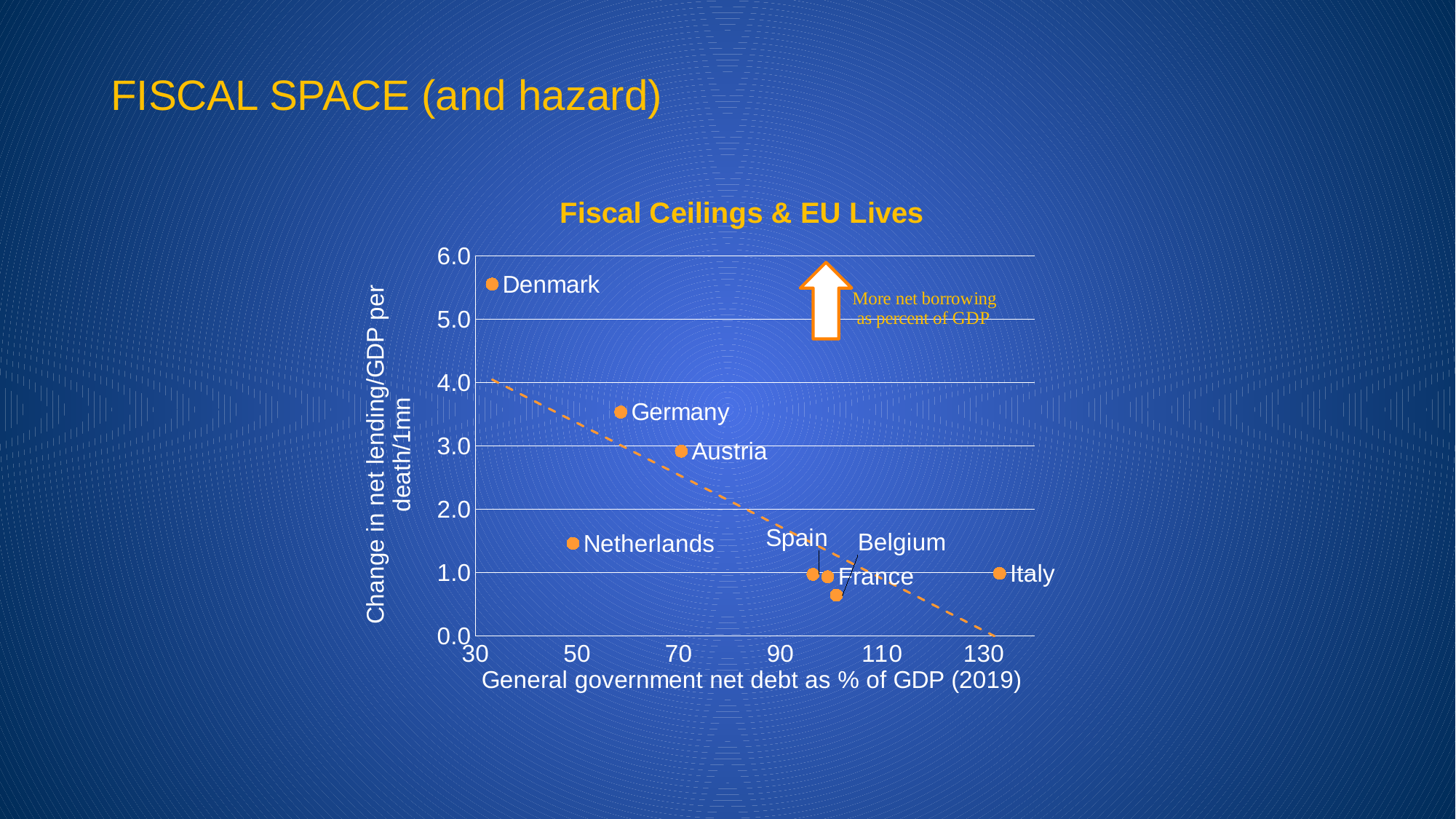
What kind of chart is shown on the slide? Scatter chart Which country has the highest change in net lending/GDP per death/1mn? Denmark What is the title of the chart? Fiscal Ceilings & EU Lives Which country has the lowest change in net lending/GDP per death/1mn? France Does the dashed trend line rise or fall as general government net debt increases? Fall Is the change in net lending/GDP per death/1mn for Denmark greater or less than 5.0? greater How many countries are plotted as points on the chart? 8 Is the general government net debt as % of GDP for Denmark greater or less than 50? less Is the change in net lending/GDP per death/1mn for Netherlands greater or less than 2.0? less Which has a higher change in net lending/GDP per death/1mn, Germany or Netherlands? Germany Which country has a higher general government net debt as % of GDP, Italy or Denmark? Italy